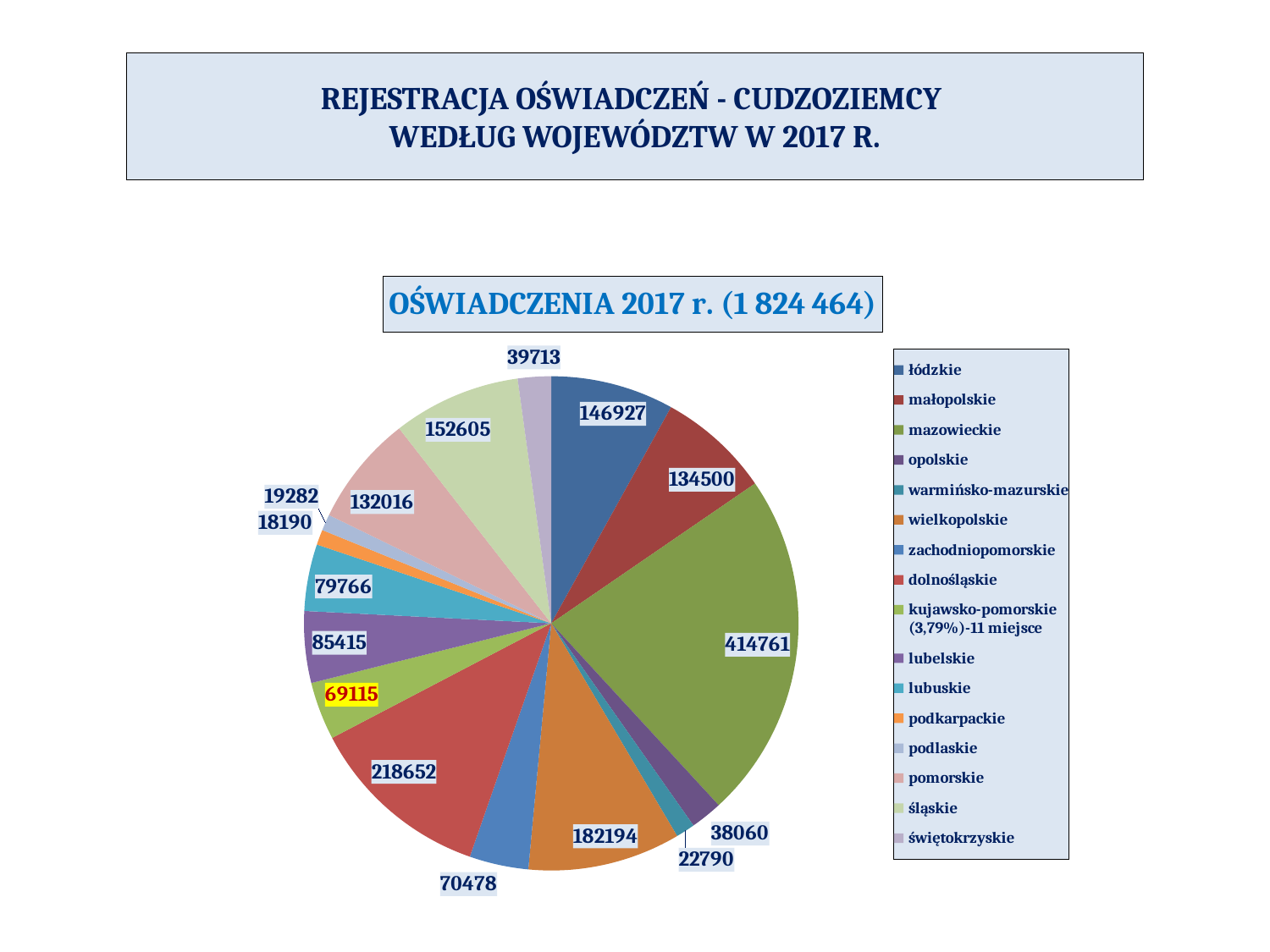
Which is larger, the value for wielkopolskie or the value for dolnośląskie? dolnośląskie Which voivodeship has the largest slice of the pie chart? mazowieckie What kind of chart is shown on the slide? pie chart What share of the pie does kujawsko-pomorskie represent, according to the legend? 3,79% What is the value for śląskie in the pie chart? 152605 What total number of declarations for 2017 is given in the chart title? 1 824 464 What is the value for kujawsko-pomorskie in the pie chart? 69115 What is the value for dolnośląskie in the pie chart? 218652 How many voivodeships are shown in the pie chart? 16 What is the difference between the values for łódzkie and małopolskie? 12427 Which voivodeship has the smallest slice of the pie chart? podkarpackie What is the value for mazowieckie in the pie chart? 414761